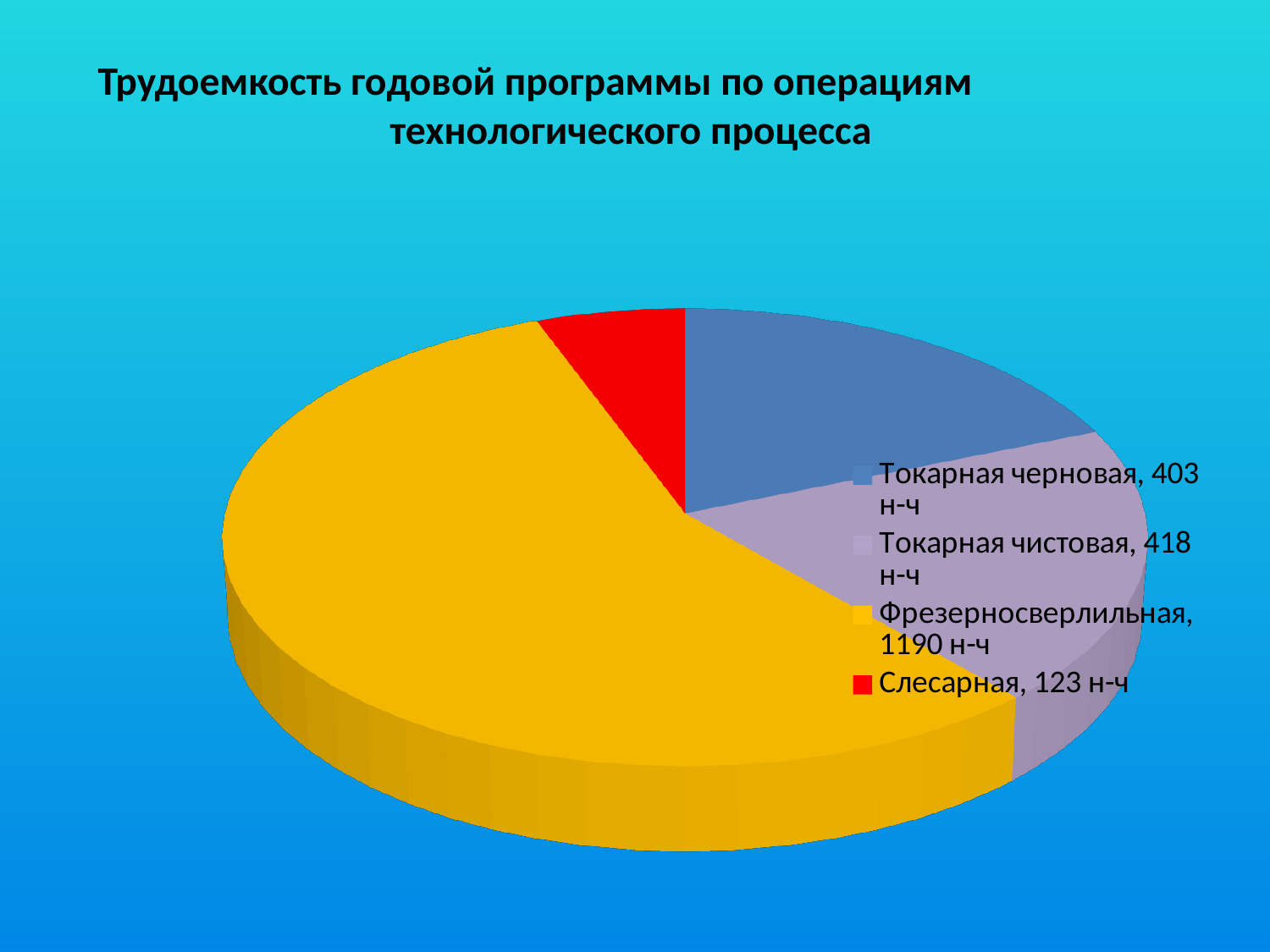
What is the difference between the values for Фрезерносверлильная and Слесарная? 1067 н-ч Which operation has the smallest share of the pie? Слесарная Which is larger, the value for Токарная чистовая or Токарная черновая? Токарная чистовая What is the value for Слесарная? 123 н-ч What is the difference between the values for Токарная чистовая and Токарная черновая? 15 н-ч What is the title of the chart? Трудоемкость годовой программы по операциям технологического процесса How many operations (slices) does the pie chart show? 4 What kind of chart is shown on the slide? pie chart What is the value for Токарная черновая? 403 н-ч Which operation has the largest share of the pie? Фрезерносверлильная What is the value for Фрезерносверлильная? 1190 н-ч What colour is the slice for Слесарная? red